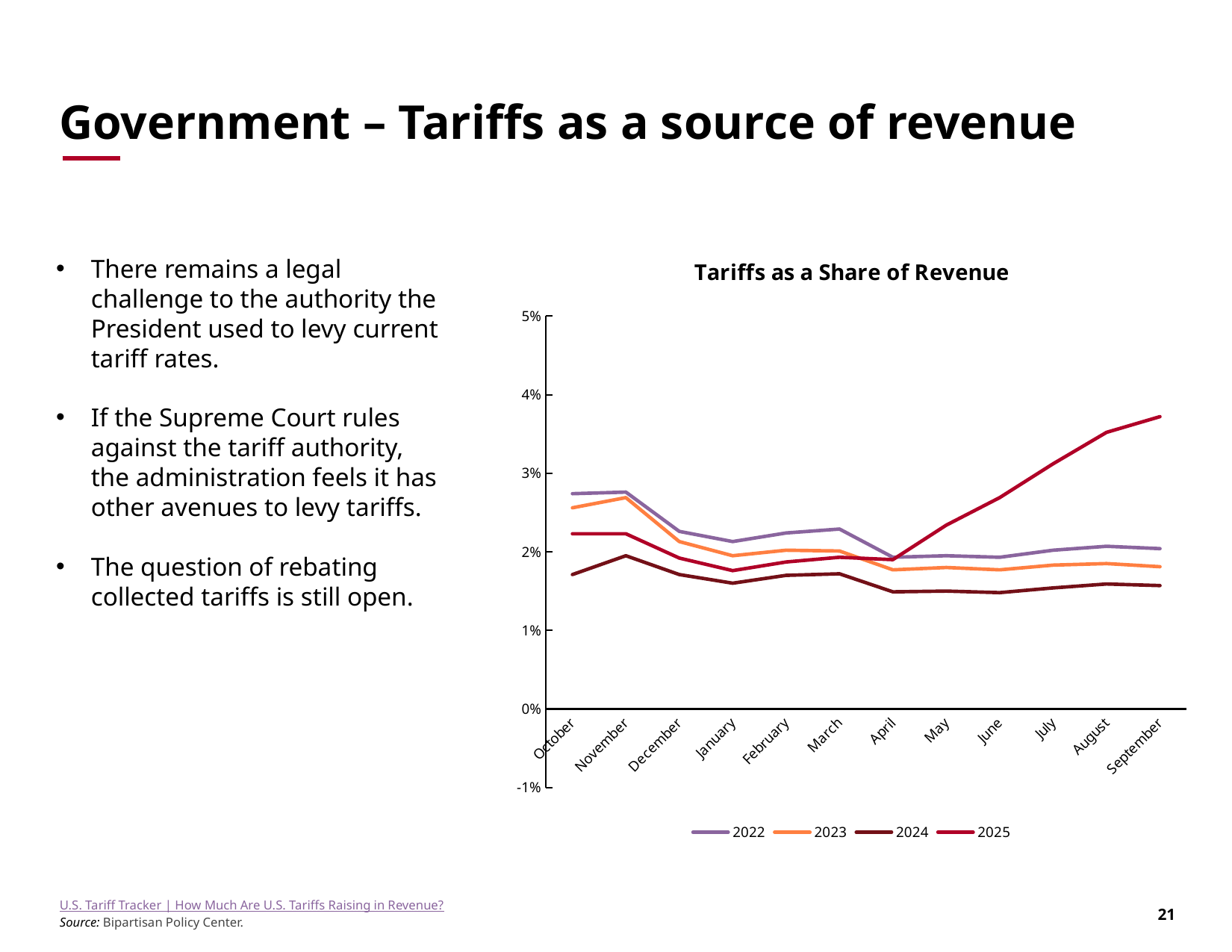
What is the title of the chart? Tariffs as a Share of Revenue How many months are shown along the x axis of the chart? 12 Which is larger in August, the value for 2025 or the value for 2022? 2025 Which series is drawn in orange in the chart? 2023 What kind of chart is shown on the slide? line chart Which series has the lowest value in September? 2024 Is the value for 2025 in September greater or less than 3%? greater Is the value for 2022 in October greater or less than 2%? greater Is the value for 2024 in June greater or less than 2%? less Does the 2025 series rise or fall from April to September? rise How many series does the chart's legend list? 4 Which series has the highest value in September? 2025